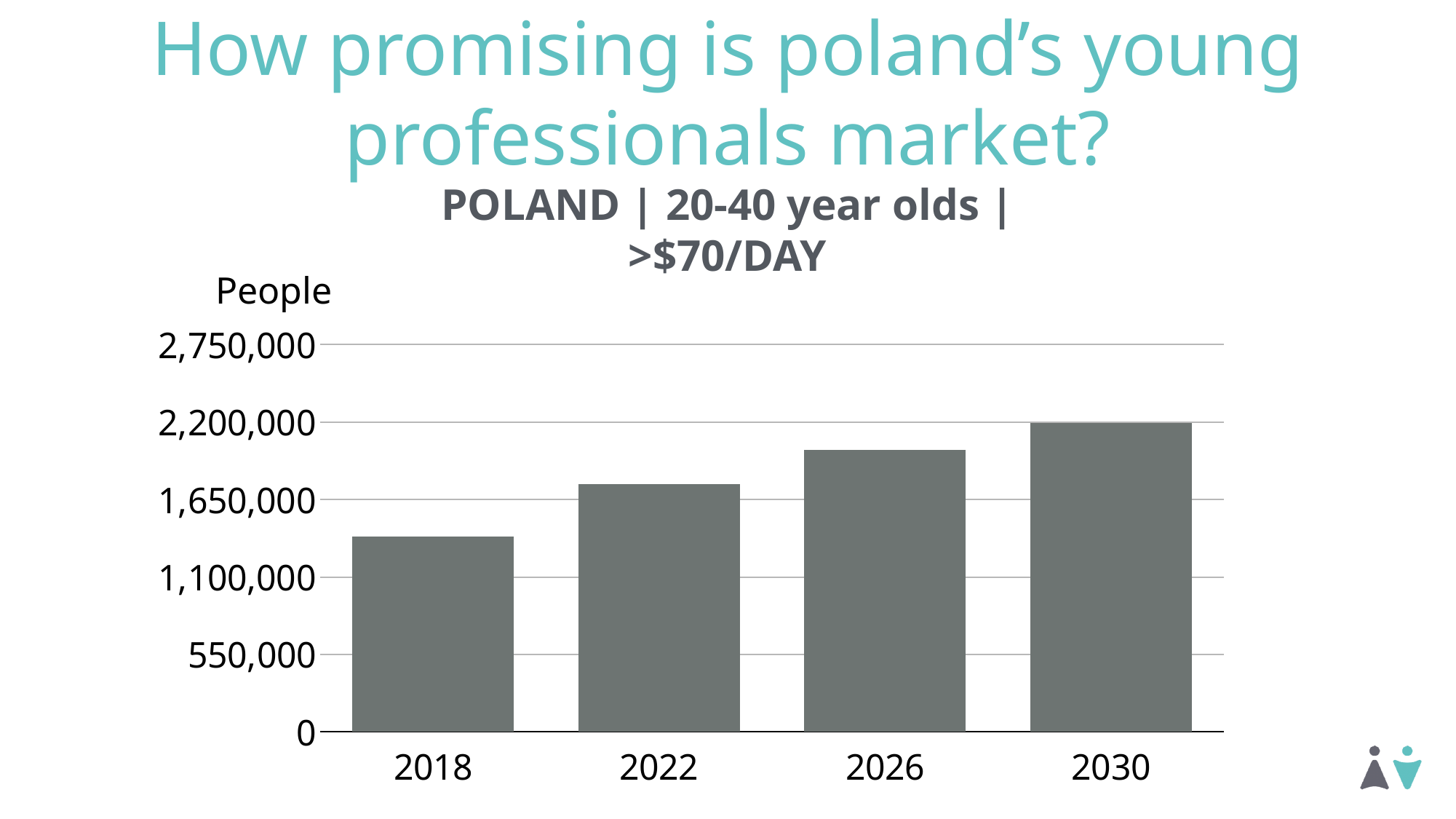
Is the value for 2022 greater or less than 1,650,000? greater Which year has the highest number of people? 2030 Is the value for 2018 greater or less than 1,650,000? less What is the label on the vertical axis of the chart? People Which year has the lowest number of people? 2018 What is the title of the chart? POLAND | 20-40 year olds | >$70/DAY Is the value for 2018 greater or less than 1,100,000? greater Which is larger, the value for 2022 or the value for 2026? 2026 What kind of chart is shown on the slide? bar chart Do the values rise or fall from 2018 to 2030? rise How many years are plotted on the chart? 4